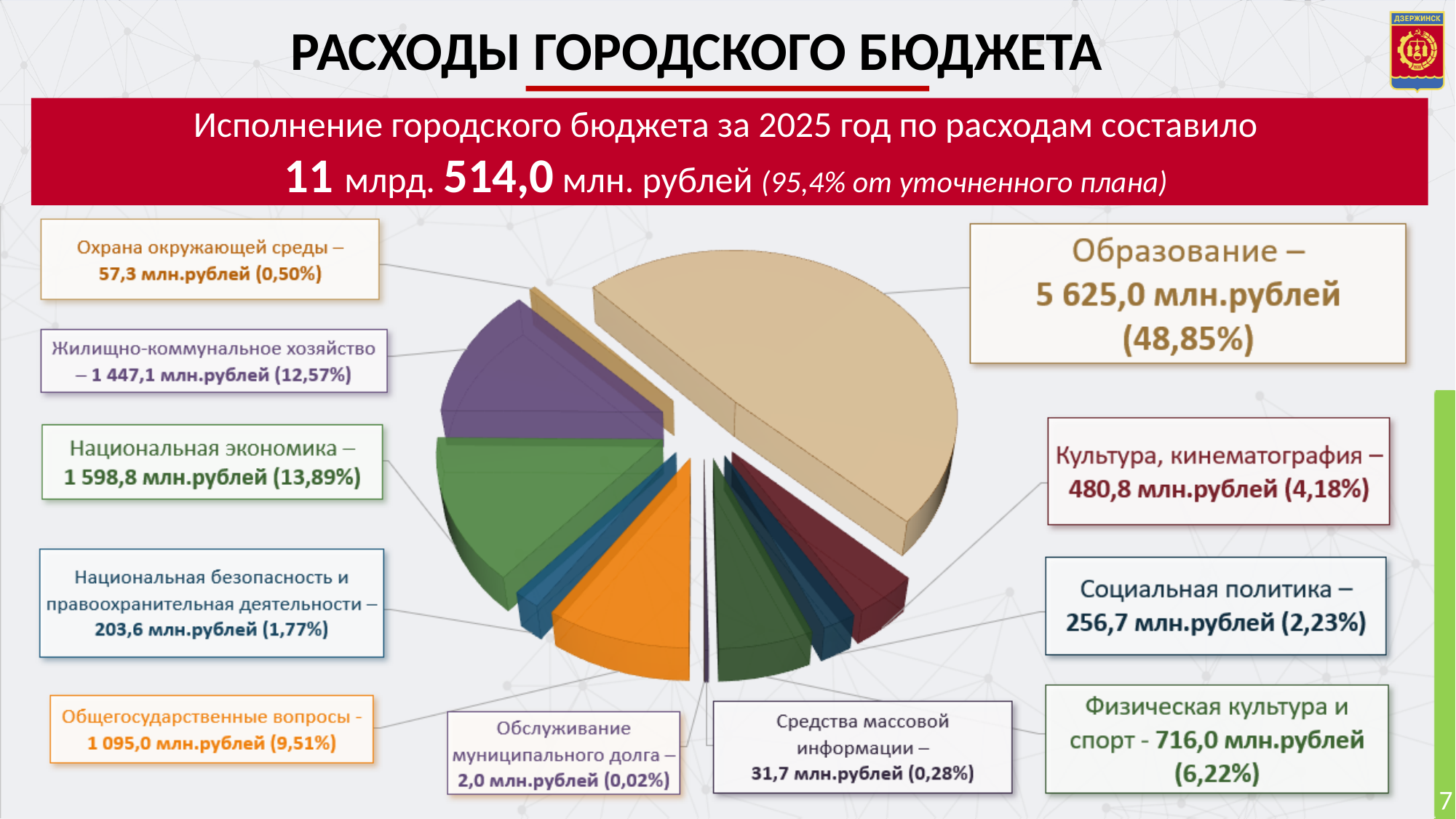
Сколько млн. рублей составили расходы на физическую культуру и спорт? 716,0 млн.рублей Какая категория расходов имеет наименьшее значение? Обслуживание муниципального долга Сколько млн. рублей составили расходы на образование? 5 625,0 млн.рублей Какова доля расходов на жилищно-коммунальное хозяйство? 12,57% Какая категория расходов имеет наибольшее значение? Образование Сколько категорий расходов показано на круговой диаграмме? 11 Какова доля расходов на средства массовой информации? 0,28% На сколько млн. рублей расходы на национальную экономику превышают расходы на жилищно-коммунальное хозяйство? 151,7 млн.рублей Каким цветом на диаграмме показан сектор «Общегосударственные вопросы»? Оранжевым На сколько млн. рублей расходы на физическую культуру и спорт больше расходов на культуру и кинематографию? 235,2 млн.рублей Какой тип диаграммы показан на слайде? Круговая диаграмма Что больше: расходы на национальную экономику или на жилищно-коммунальное хозяйство? Национальная экономика